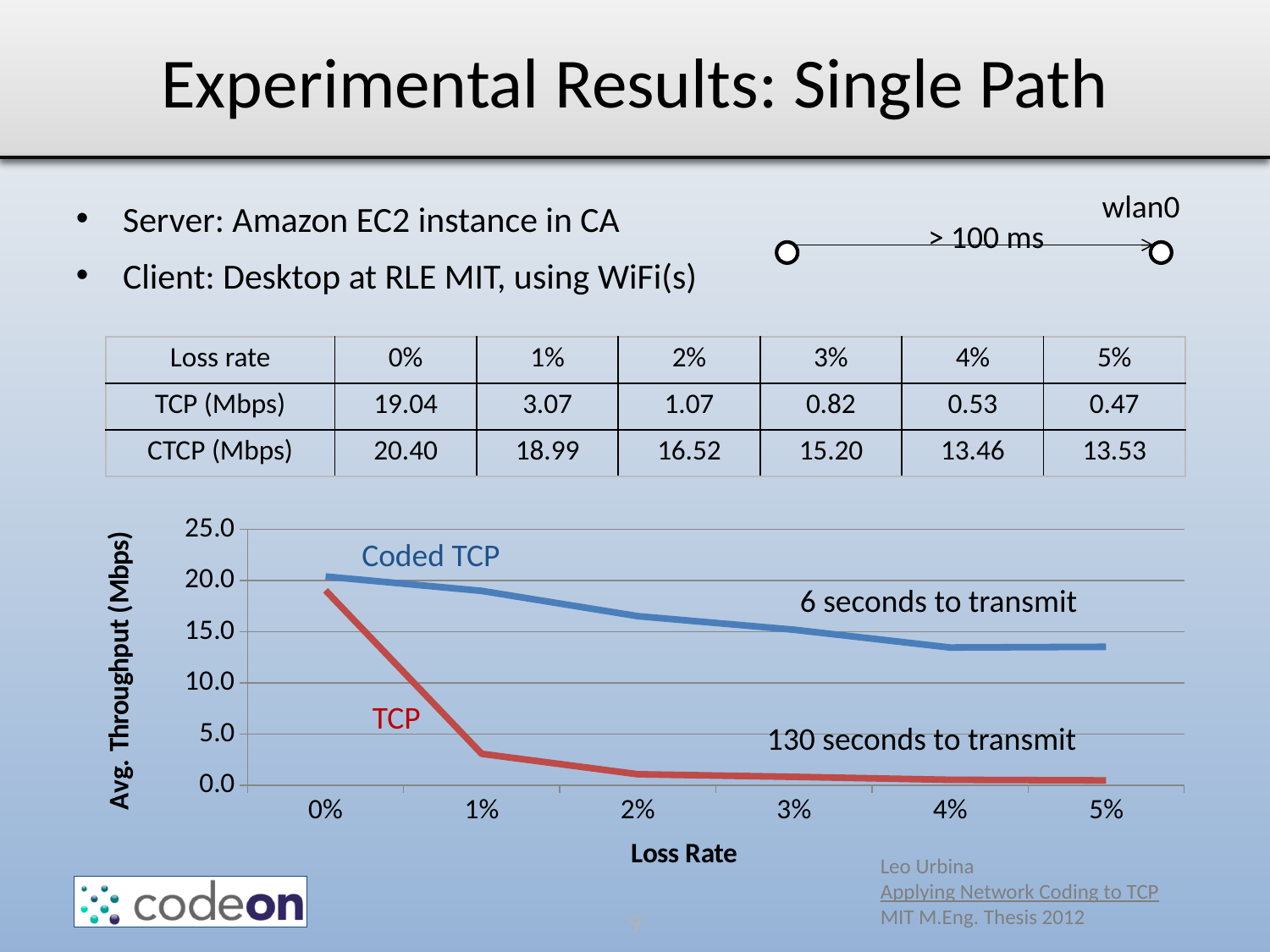
How many loss rate values are plotted along the x axis of the chart? 6 At which loss rate is the TCP throughput lowest? 5% What is the CTCP throughput at a 5% loss rate? 13.53 What is the difference between the CTCP and TCP throughput at a 1% loss rate? 15.92 What is the label on the x axis of the chart? Loss Rate What kind of chart is shown on the slide? line chart What is the TCP throughput at a 0% loss rate? 19.04 How many series are plotted in the chart? 2 Which series has the higher throughput at a 3% loss rate, TCP or Coded TCP? Coded TCP Is the Coded TCP throughput at a 2% loss rate greater or less than 15.0? greater What is the label on the y axis of the chart? Avg. Throughput (Mbps) At which loss rate is the CTCP throughput highest? 0%